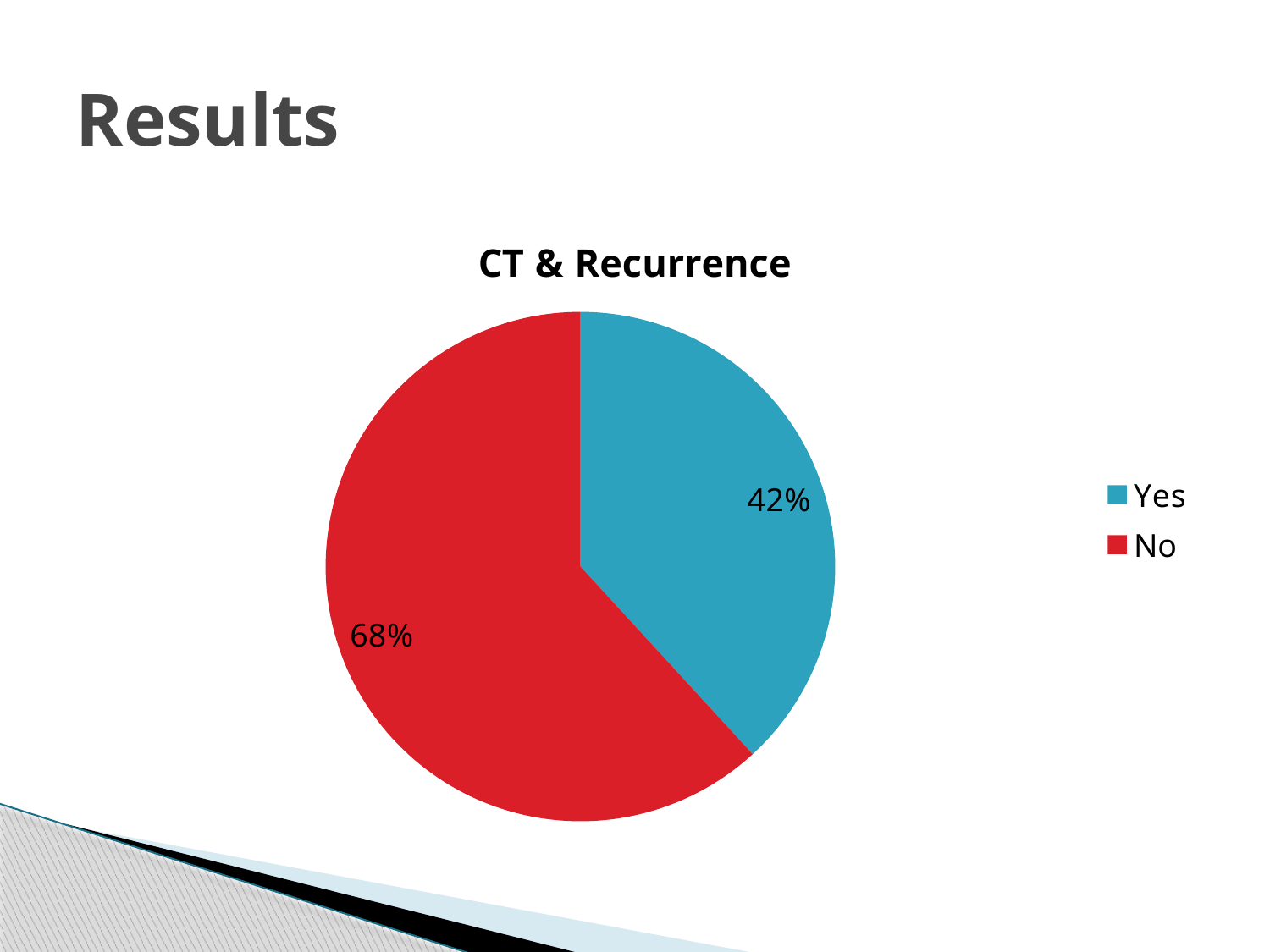
What percentage is shown for the Yes slice? 42% What share of the pie does the No slice represent? 68% What is the difference between the No and Yes percentages? 26% Which slice is the largest? No What percentage is shown for the No slice? 68% Which is larger, the Yes slice or the No slice? No How many slices does the pie chart have? 2 What is the title of the chart? CT & Recurrence Which slice is the smallest? Yes How many entries does the legend list? 2 What kind of chart is shown on the slide? pie chart What colour is the Yes slice? blue